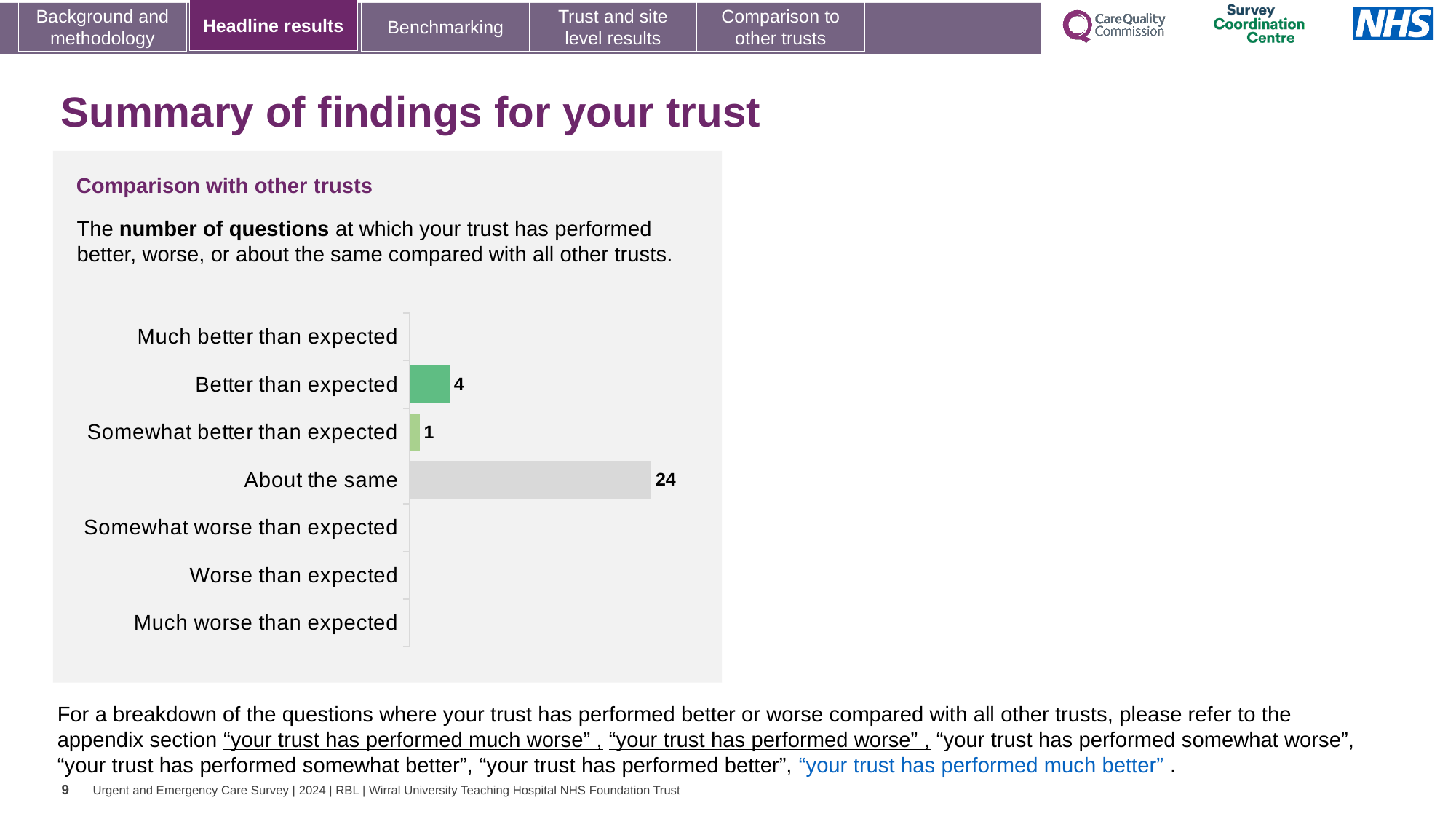
What is the value for "Somewhat better than expected"? 1 What is the difference between the values for "Better than expected" and "Somewhat better than expected"? 3 What is the total of the three labelled bars on the chart? 29 What is the value for "Better than expected"? 4 What is the value for "About the same"? 24 What colour is the bar for "About the same"? Grey What kind of chart is shown on the slide? Bar chart Which category has the highest value? About the same What is the difference between the values for "About the same" and "Better than expected"? 20 Which is larger, the value for "Better than expected" or the value for "Somewhat better than expected"? Better than expected What is the heading above the chart? Comparison with other trusts How many categories are listed on the chart's axis? 7